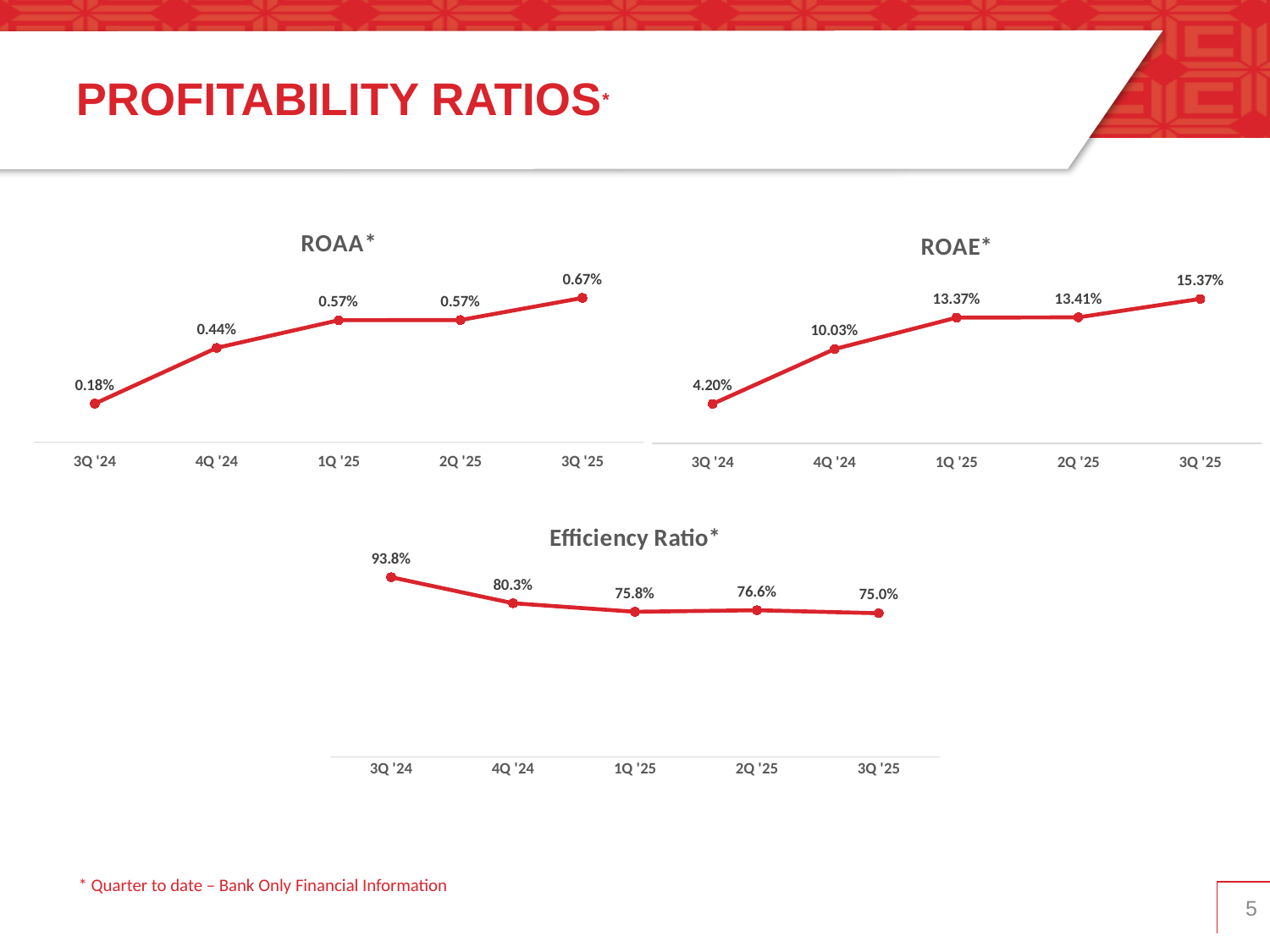
In the ROAA* chart, which quarter has the lowest value? 3Q '24 In the Efficiency Ratio* chart, which quarter has the lowest value? 3Q '25 In the ROAE* chart, what is the value for 4Q '24? 10.03% In the Efficiency Ratio* chart, is the value for 1Q '25 or 2Q '25 larger? 2Q '25 In the ROAA* chart, what is the value for 3Q '25? 0.67% How many quarters are plotted in the Efficiency Ratio* chart? 5 In the ROAE* chart, do the values generally rise or fall from 3Q '24 to 3Q '25? rise What type of chart is the ROAA* chart? line chart In the ROAA* chart, what is the difference between the 3Q '25 value and the 3Q '24 value? 0.49% In the ROAE* chart, what is the difference between the 3Q '25 value and the 2Q '25 value? 1.96% In the Efficiency Ratio* chart, what is the value for 3Q '24? 93.8% In the ROAE* chart, which quarter has the highest value? 3Q '25